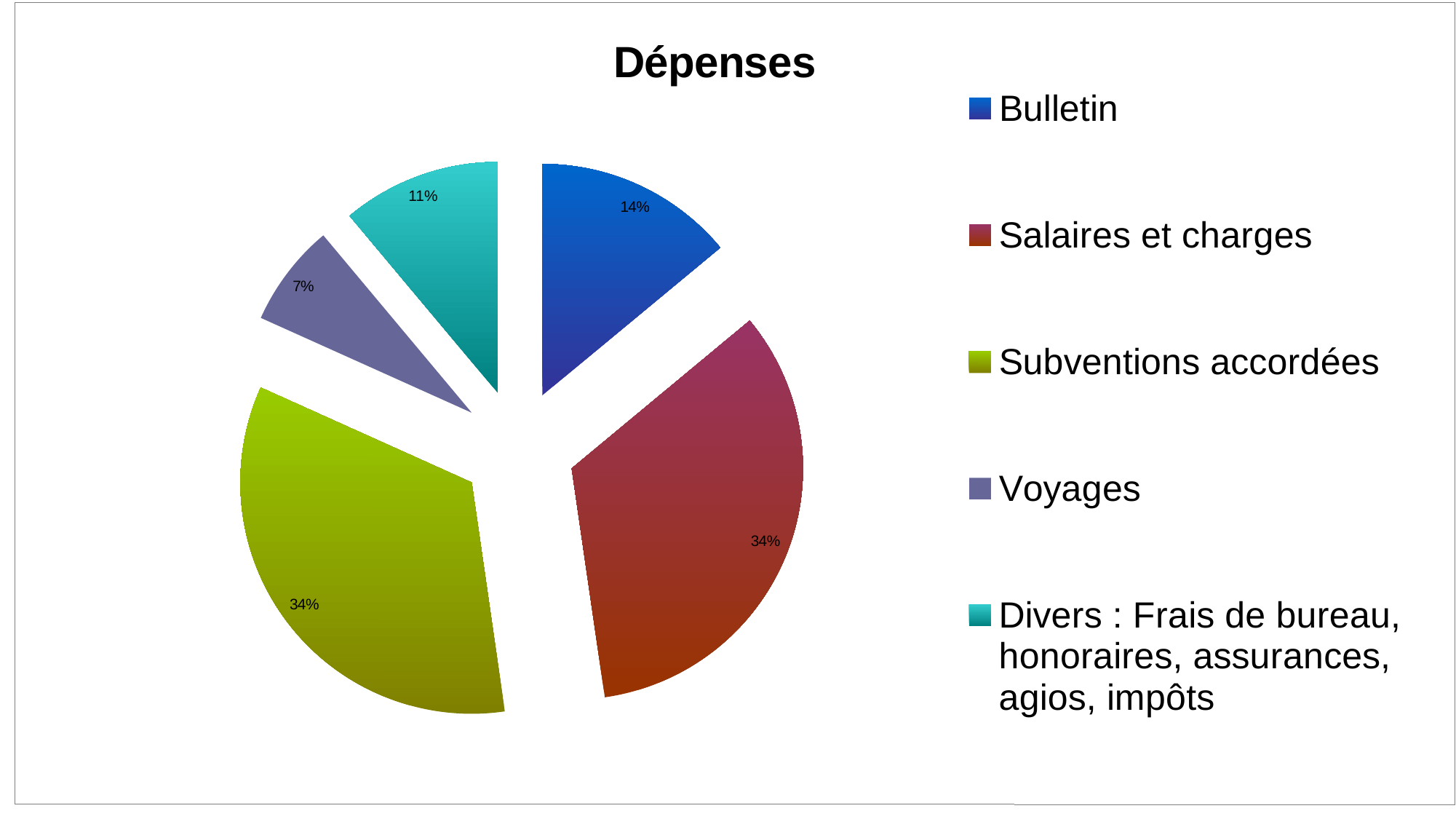
What share of the pie does Bulletin represent? 14% What share of the pie does Salaires et charges represent? 34% What share of the pie does Voyages represent? 7% What is the difference in percentage points between the Bulletin share and the Voyages share? 7 Which is larger, the share for Bulletin or the share for Voyages? Bulletin What is the title of the chart? Dépenses How many slices does the pie chart have? 5 What kind of chart is shown on the slide? pie chart Which category has the smallest slice of the pie? Voyages Which is larger, the share for Divers or the share for Salaires et charges? Salaires et charges